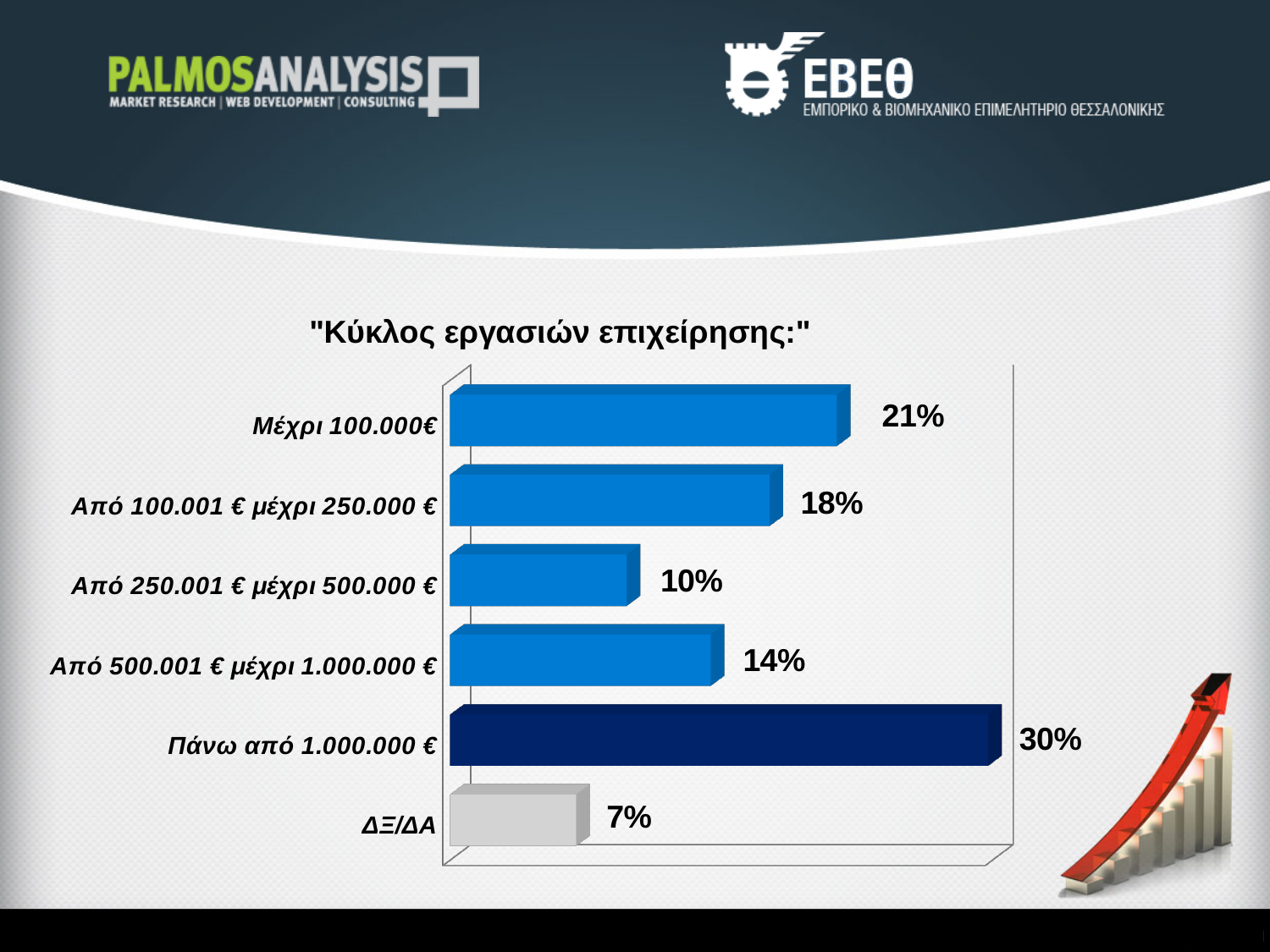
What is the difference between the values for "Πάνω από 1.000.000 €" and "Μέχρι 100.000€"? 9% What is the value for "Πάνω από 1.000.000 €"? 30% Which is larger, the value for "Από 500.001 € μέχρι 1.000.000 €" or "Από 250.001 € μέχρι 500.000 €"? Από 500.001 € μέχρι 1.000.000 € What kind of chart is shown on the slide? Bar chart What is the value for "Μέχρι 100.000€"? 21% How many categories are shown in the chart? 6 What is the value for "Από 250.001 € μέχρι 500.000 €"? 10% Which category has the highest value? Πάνω από 1.000.000 € What is the value for "ΔΞ/ΔΑ"? 7% What is the value for "Από 100.001 € μέχρι 250.000 €"? 18% What is the title of the chart? "Κύκλος εργασιών επιχείρησης:" Which category has the lowest value? ΔΞ/ΔΑ